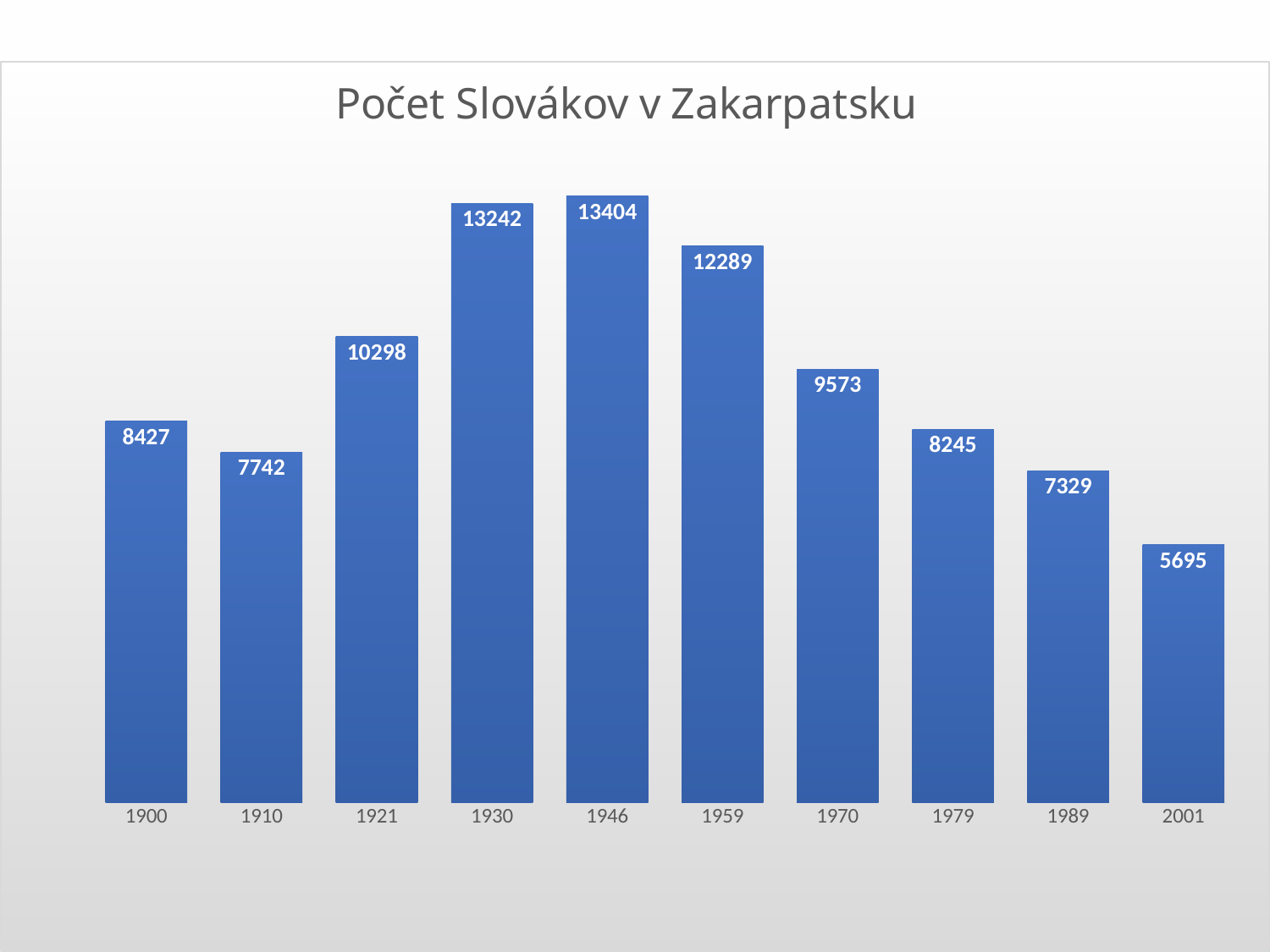
Which is larger, the value for 1959 or the value for 1970? 1959 Which year has the lowest value? 2001 What kind of chart is this? bar chart Do the values rise or fall from 1959 to 2001? fall What is the difference between the values for 1900 and 2001? 2732 Which year has the highest value? 1946 Which is larger, the value for 1910 or the value for 1979? 1979 How many years are shown on the x axis? 10 What is the difference between the values for 1946 and 1930? 162 What is the value for 1989? 7329 What is the value for 1921? 10298 What is the title of the chart? Počet Slovákov v Zakarpatsku